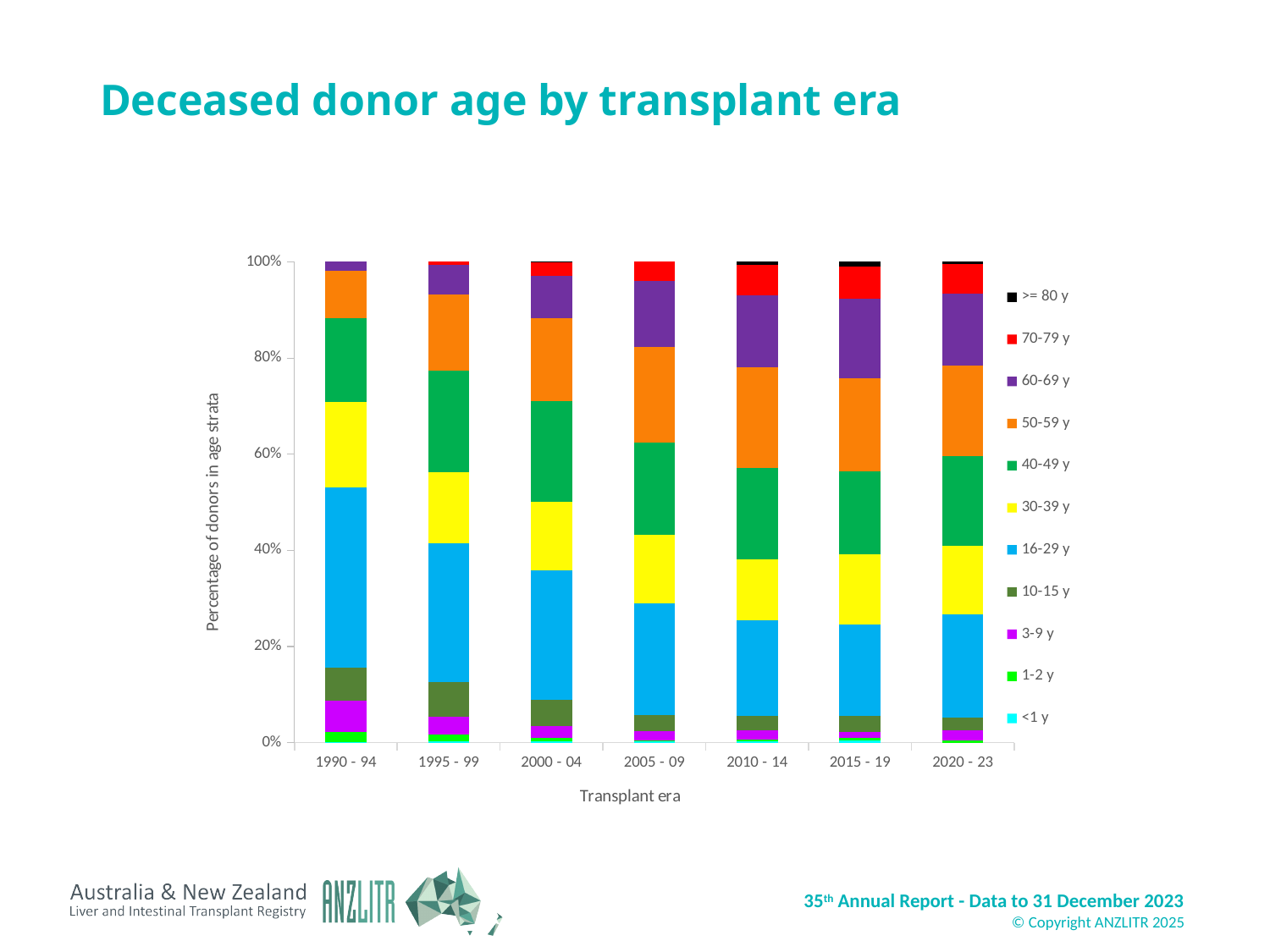
What is the total of the stacked bar for 2020 - 23? 100% Which transplant era has the smallest 60-69 y segment? 1990 - 94 Is the 60-69 y segment larger in 2015 - 19 or in 1990 - 94? 2015 - 19 What kind of chart is shown on the slide? Stacked bar chart Does the share of 16-29 y donors rise or fall from 1990 - 94 to 2005 - 09? Fall What is the title of the chart? Deceased donor age by transplant era How many transplant eras are shown on the x axis? 7 Which transplant era has the largest 16-29 y segment? 1990 - 94 Is the 16-29 y segment larger in 1990 - 94 or in 2020 - 23? 1990 - 94 What is the label of the y axis? Percentage of donors in age strata Is the 16-29 y segment in 1990 - 94 greater or less than 20%? greater How many age strata does the legend list? 11